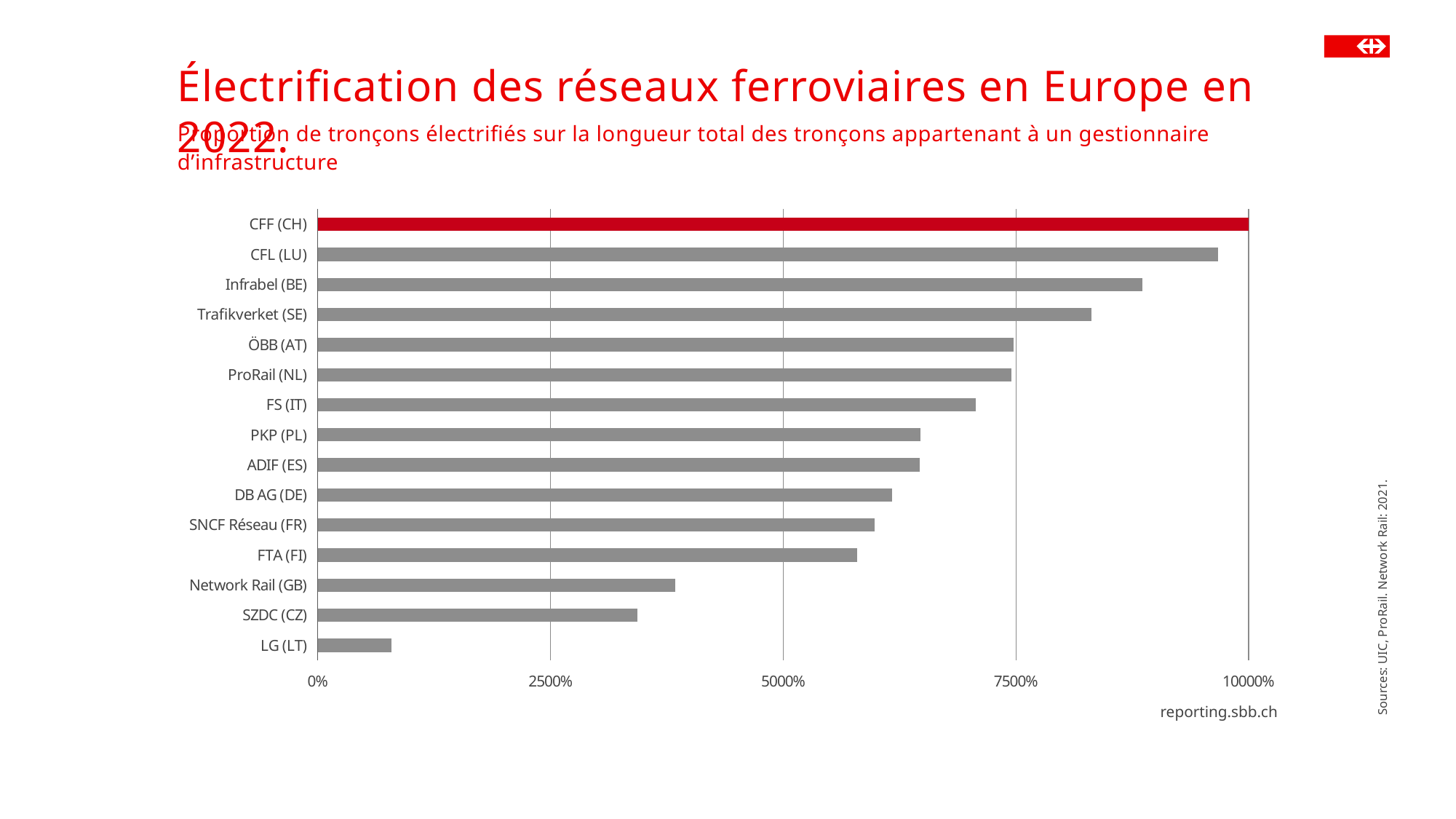
Which infrastructure manager has the highest value in the chart? CFF (CH) Is the value for CFL (LU) greater or less than 7500%? greater Is the value for LG (LT) greater or less than 2500%? less Is the value for SZDC (CZ) greater or less than 2500%? greater Which infrastructure manager has the lowest value in the chart? LG (LT) Which has the larger value, Network Rail (GB) or SZDC (CZ)? Network Rail (GB) What kind of chart is shown on the slide? bar chart Which bar in the chart is highlighted in red? CFF (CH) How many infrastructure managers are listed in the chart? 15 Which has the larger value, Trafikverket (SE) or ÖBB (AT)? Trafikverket (SE)